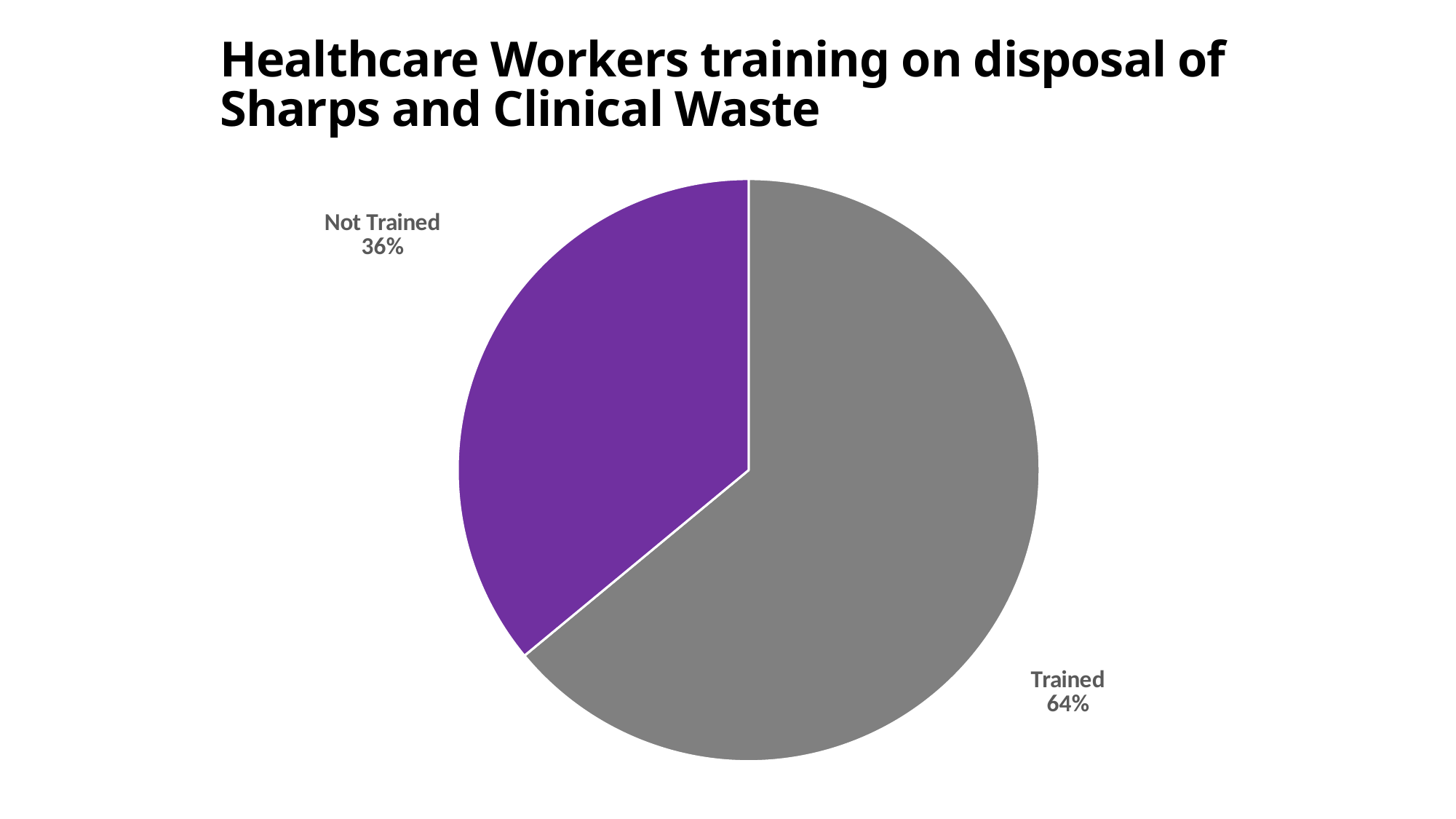
What share of the pie does the Trained slice represent? 64% What percentage of healthcare workers are Not Trained? 36% Which category has the largest share of the pie? Trained What kind of chart is shown on the slide? Pie chart Which category has the smallest share of the pie? Not Trained What percentage of healthcare workers are Trained? 64% What is the title of the chart? Healthcare Workers training on disposal of Sharps and Clinical Waste What is the difference in percentage points between Trained and Not Trained? 28 What colour is the Not Trained slice? Purple How many slices does the pie chart have? 2 Which is larger, the Trained share or the Not Trained share? Trained